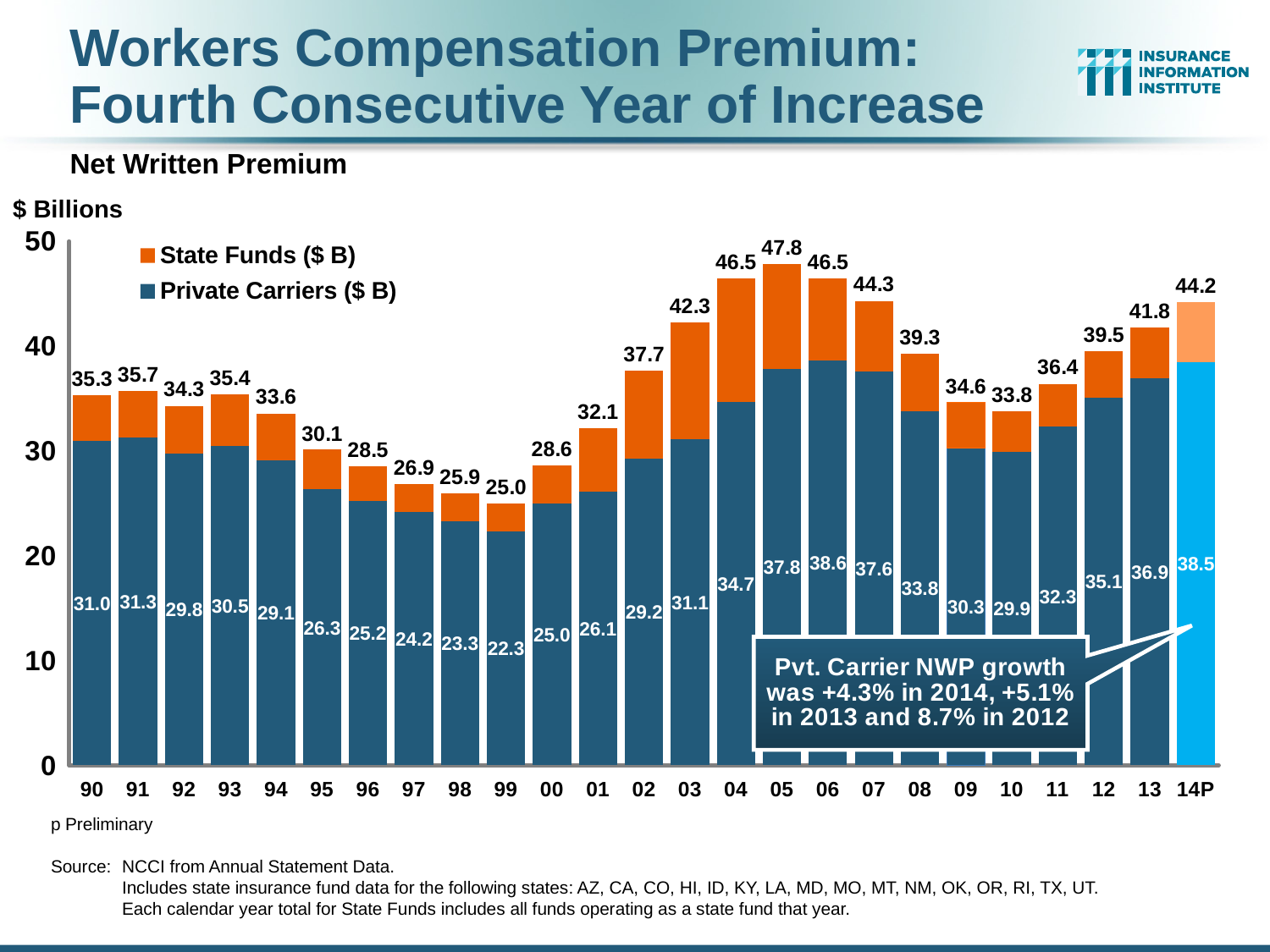
What is the total net written premium shown for 2005? 47.8 How many series does the legend list? 2 What kind of chart is this? stacked bar chart What is the difference between the total for 14P and the total for 13? 2.4 Is the total for 1999 greater or less than 30? less Which year has the highest total net written premium? 05 What is the Private Carriers value shown for 14P? 38.5 What is the State Funds portion for 2005, given the total of 47.8 and Private Carriers of 37.8? 10.0 Which year has the lowest total net written premium? 99 Do the totals rise or fall from 2010 to 14P? rise How many years are shown on the x axis? 25 Is the total for 2004 larger or smaller than the total for 2007? larger